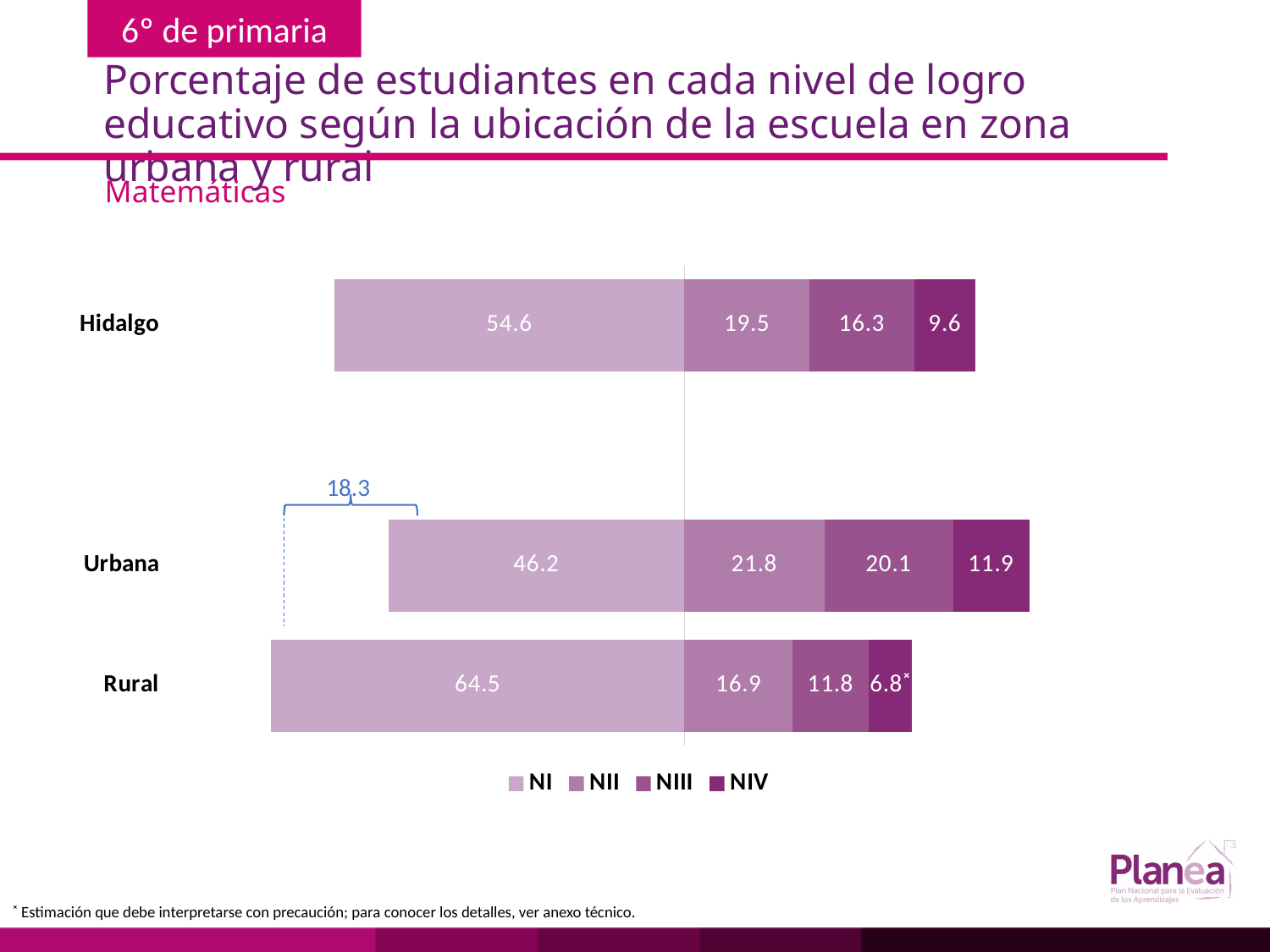
Which is larger, the NIII value for Urbana or the NIII value for Hidalgo? Urbana What is the NI value for Rural? 64.5 How many series does the legend list? 4 Which category has the lowest NIV value? Rural What is the NII value for Hidalgo? 19.5 What kind of chart is shown on the slide? Stacked bar chart What is the NIV value for Urbana? 11.9 How many categories are shown on the chart? 3 Which category has the highest NI value? Rural What is the total of the stacked bar for Hidalgo? 100.0 What is the difference between the NI values for Rural and Urbana? 18.3 Which value on the chart is marked with an asterisk? 6.8 (NIV for Rural)